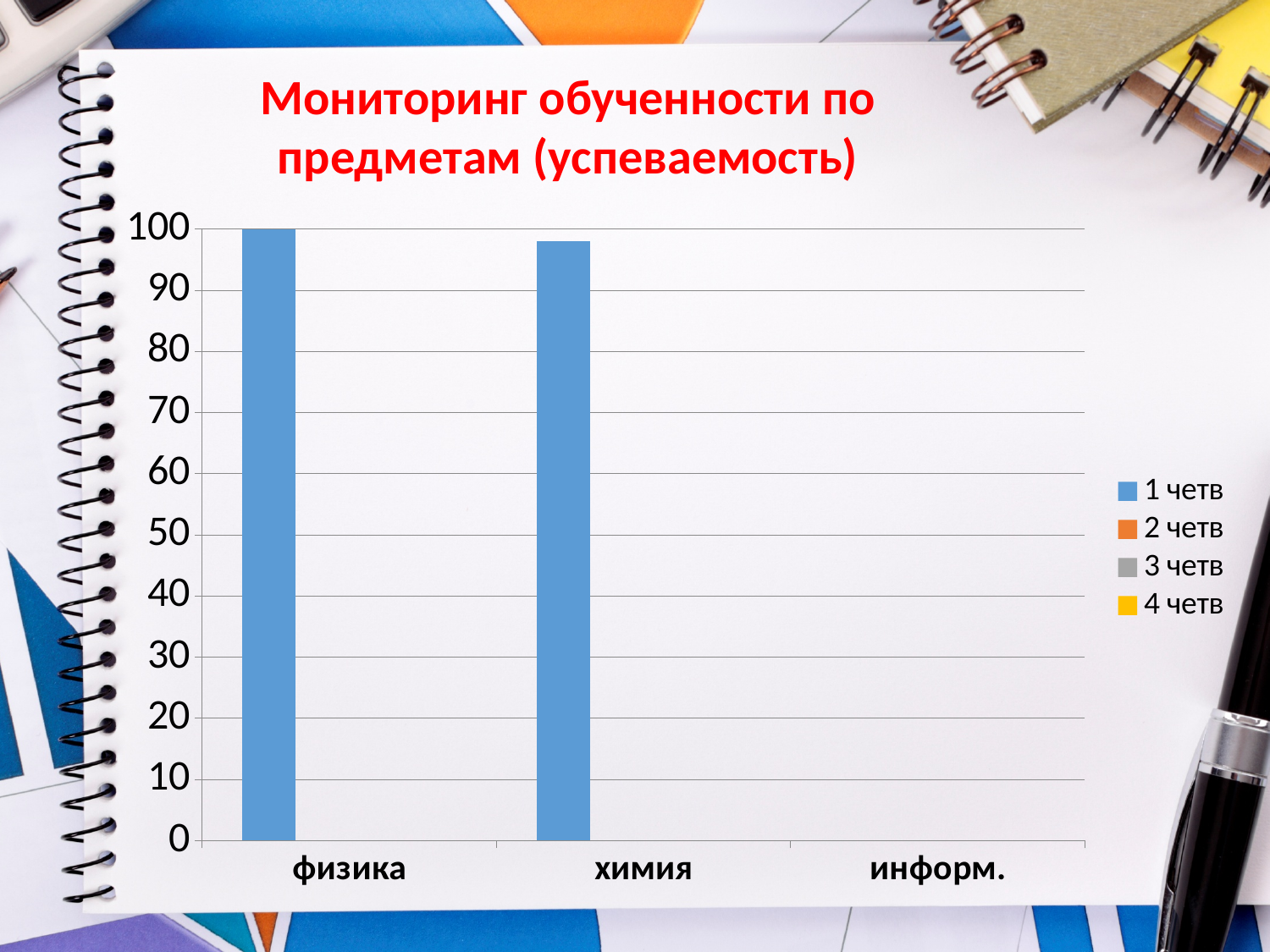
What kind of chart is shown on the slide? bar chart Which legend entry is shown in blue? 1 четв Which category has no bar plotted? информ. How many series does the legend list? 4 What is the title of the chart? Мониторинг обученности по предметам (успеваемость) What is the highest value shown on the y axis? 100 Is the value for химия in the 1 четв series greater or less than 90? greater Is the value for химия in the 1 четв series greater or less than 50? greater What is the value for физика in the 1 четв series? 100 How many categories are shown on the x axis? 3